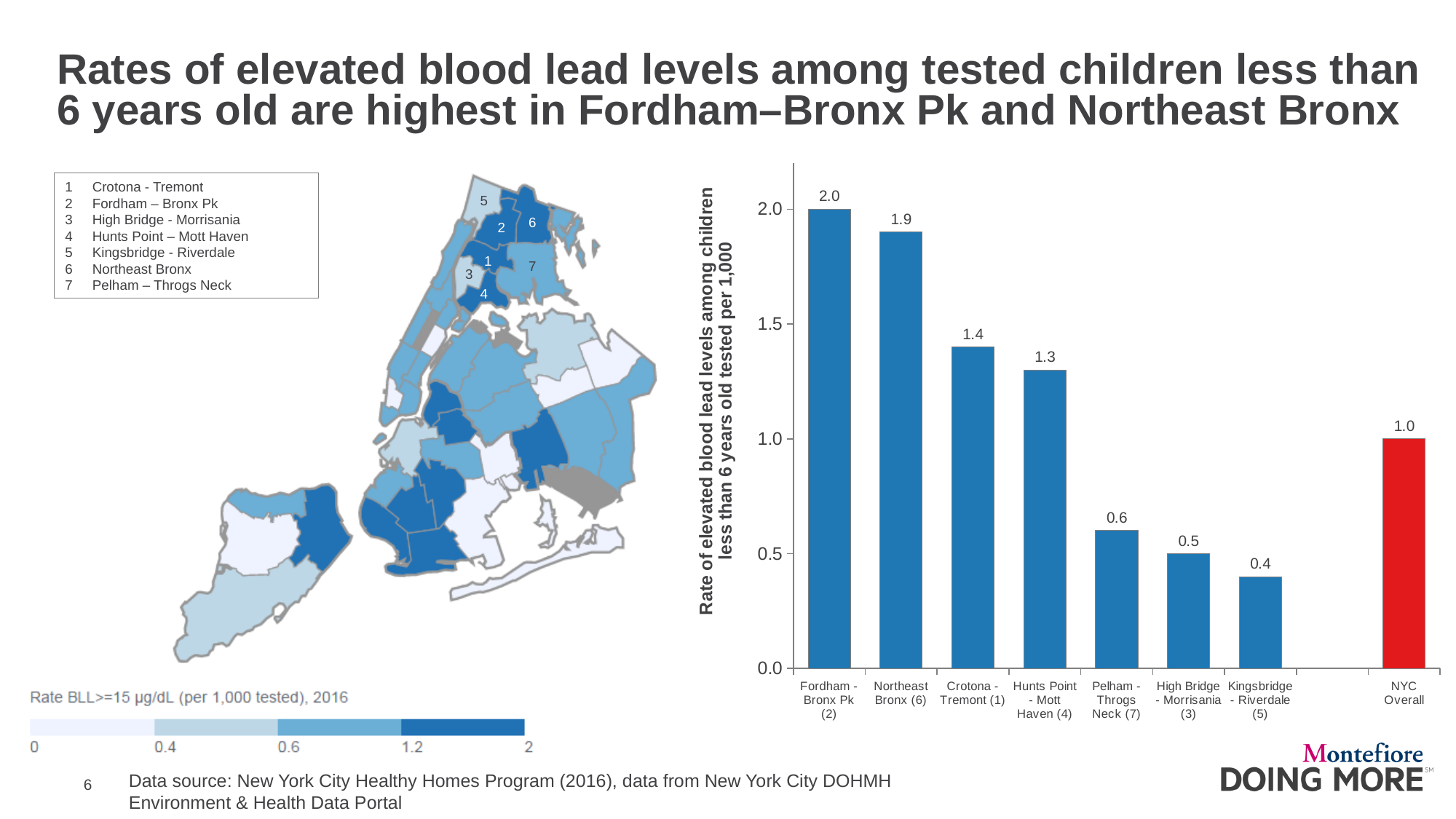
What is the difference between the rates for Fordham - Bronx Pk (2) and NYC Overall? 1.0 Which bar in the chart is colored red? NYC Overall What is the rate of elevated blood lead levels for Northeast Bronx (6)? 1.9 Which neighborhood has the lowest rate of elevated blood lead levels in the bar chart? Kingsbridge - Riverdale (5) Which neighborhood has the highest rate of elevated blood lead levels in the bar chart? Fordham - Bronx Pk (2) What is the rate for Kingsbridge - Riverdale (5)? 0.4 What is the rate of elevated blood lead levels for Fordham - Bronx Pk (2)? 2.0 What is the difference between the rates for Crotona - Tremont (1) and Hunts Point - Mott Haven (4)? 0.1 What is the value shown for NYC Overall? 1.0 How many bars are shown in the bar chart? 8 Which has a higher rate, Pelham - Throgs Neck (7) or High Bridge - Morrisania (3)? Pelham - Throgs Neck (7) What type of chart is shown on the right side of the slide? Bar chart